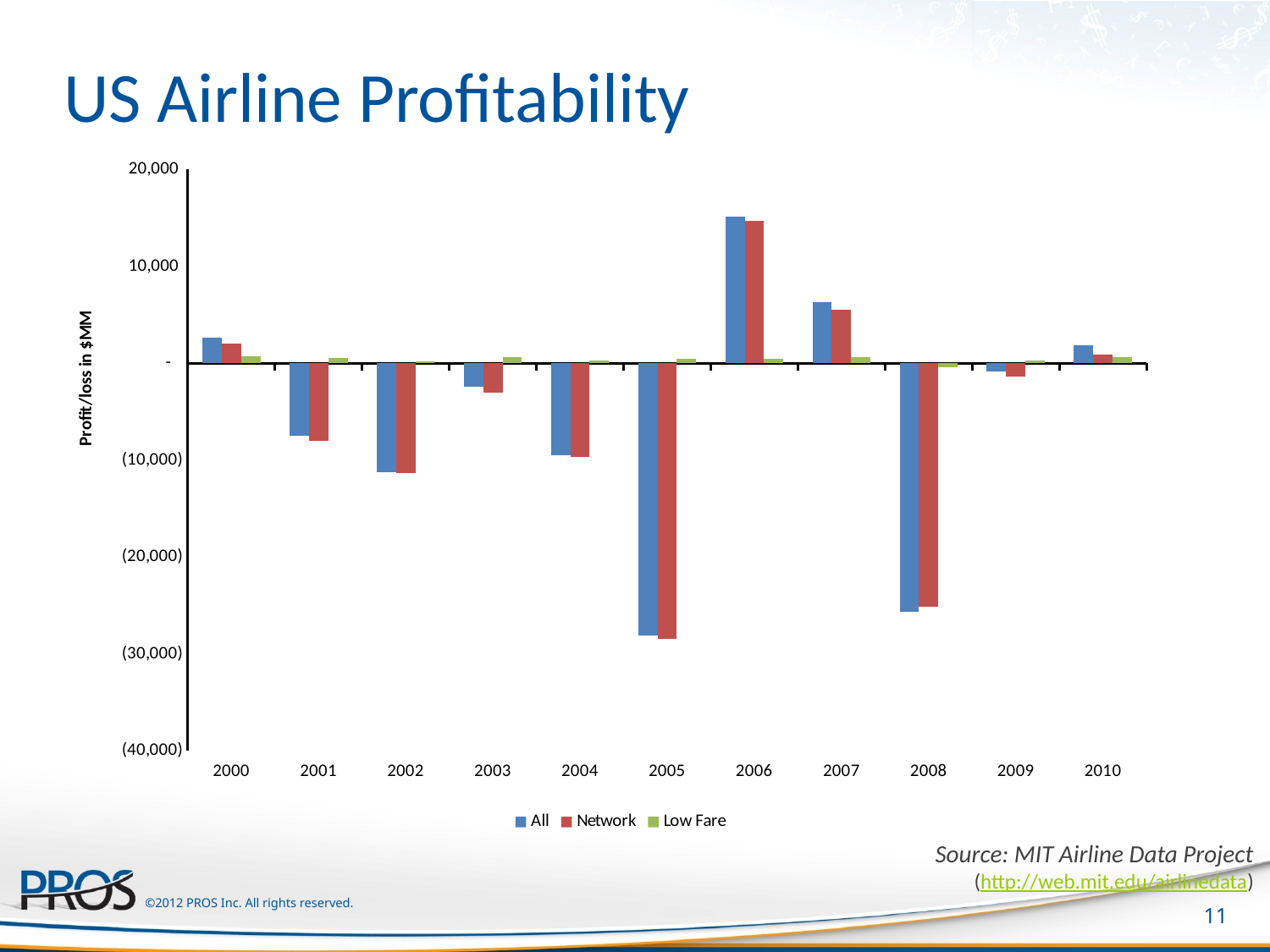
What is the label on the vertical axis of the chart? Profit/loss in $MM Is the value for All in 2006 greater or less than 10,000? greater Which is larger in 2006, the value for Network or the value for Low Fare? Network What kind of chart is shown on the slide? Bar chart In which year is the value for the All series highest? 2006 Is the value for All in 2005 greater or less than (20,000)? less What are the three series listed in the chart legend? All, Network, Low Fare In which year is the value for the Network series lowest? 2005 How many series does the chart legend list? 3 In which year is the value for the All series lowest? 2005 How many years are shown on the x axis of the chart? 11 Which is larger, the value for All in 2006 or the value for All in 2007? 2006